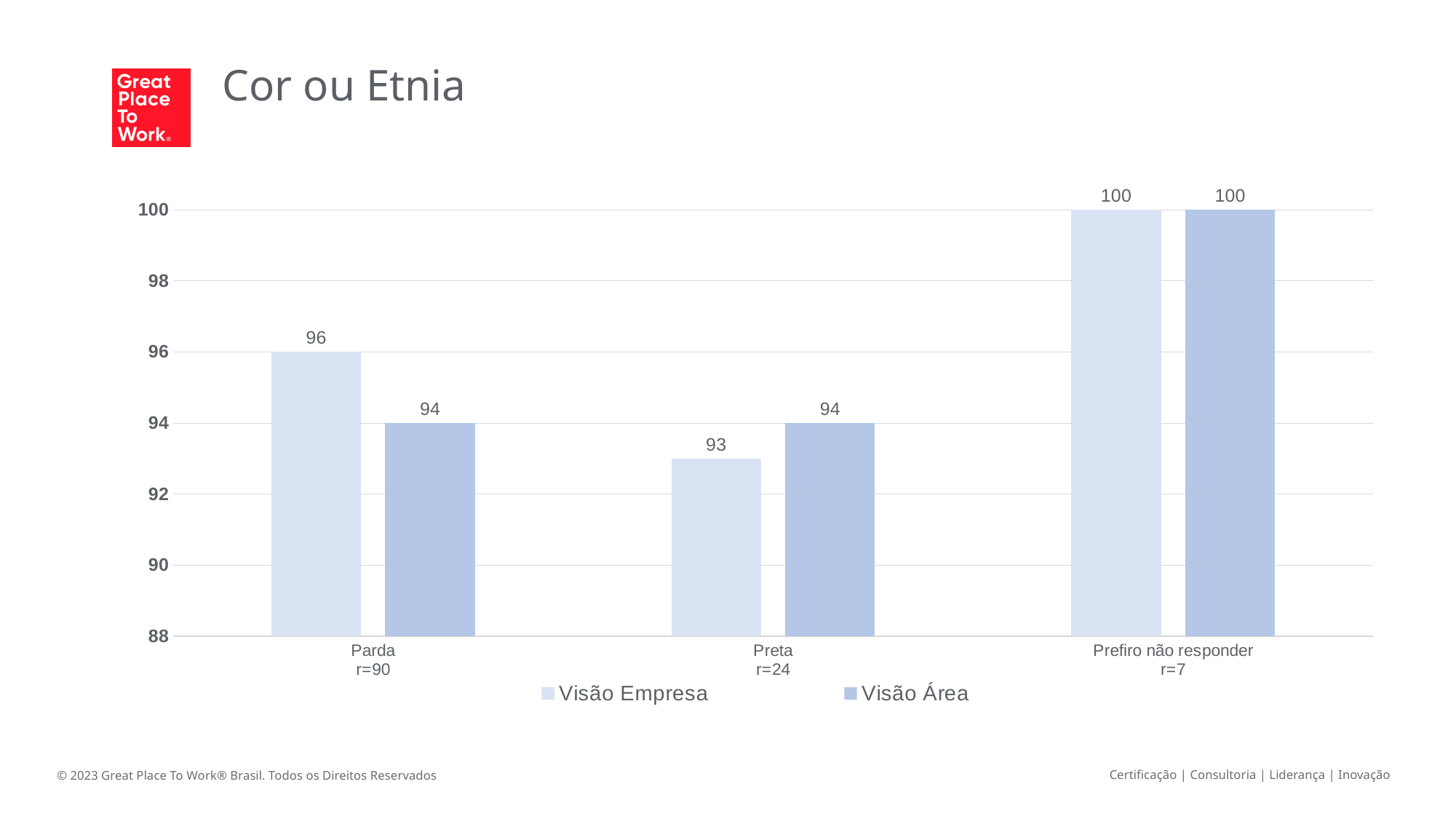
What is the Visão Empresa value for Prefiro não responder? 100 For Preta, which is larger: Visão Empresa or Visão Área? Visão Área What is the title of the slide? Cor ou Etnia Is the Visão Empresa value for Preta greater or less than 94? less What kind of chart is shown on the slide? bar chart What is the Visão Empresa value for Parda? 96 What is the difference between the Visão Empresa and Visão Área values for Parda? 2 How many series does the legend list? 2 Which category has the highest Visão Área value? Prefiro não responder What is the Visão Área value for Preta? 94 How many categories are shown on the x axis? 3 Which category has the lowest Visão Empresa value? Preta